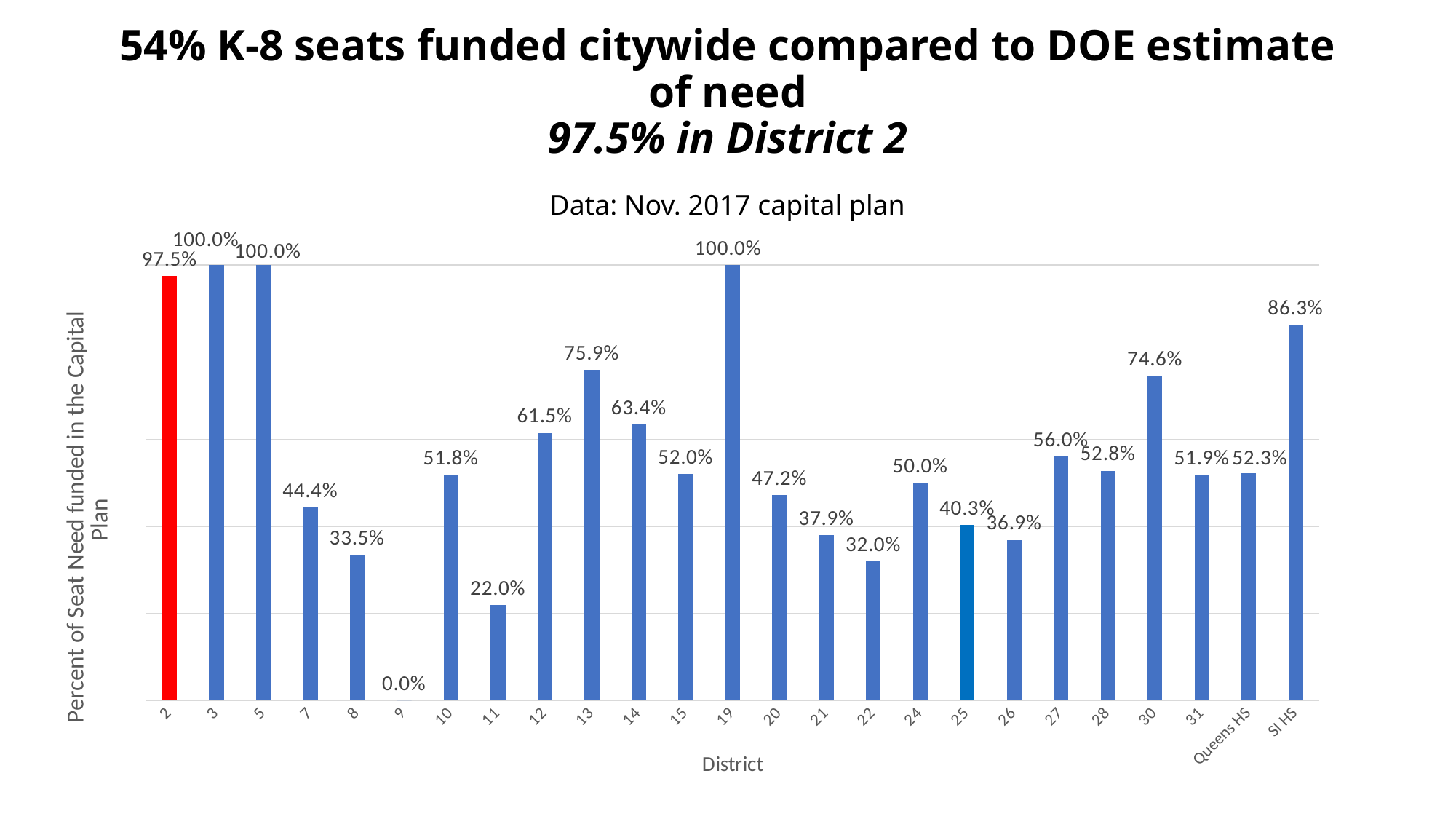
What is the value for District 11? 22.0% What is the difference between the values for District 13 and District 12? 14.4 percentage points What is the value for SI HS? 86.3% What kind of chart is shown on the slide? Bar chart Which district's bar is coloured red? 2 What is the value for District 2? 97.5% How many categories are shown on the x axis? 25 Which district has the lowest value? 9 Which is larger, the value for District 20 or District 24? District 24 What is the value for District 13? 75.9% Which is larger, the value for District 27 or District 28? District 27 What is the difference between the values for SI HS and District 30? 11.7 percentage points